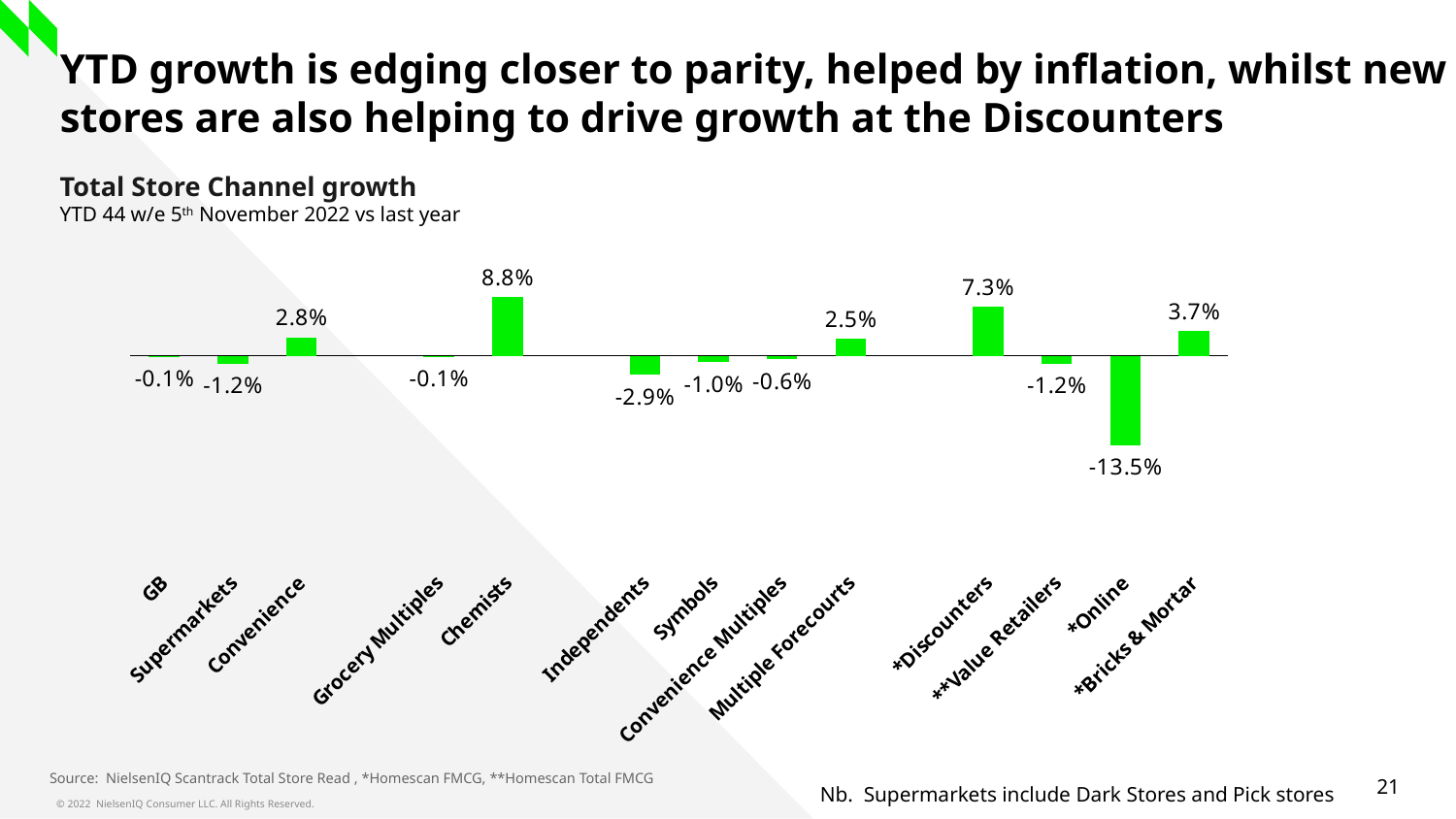
Which channel has the lowest YTD growth? Online What is the YTD growth value for Chemists? 8.8% What is the YTD growth value for Discounters? 7.3% What is the YTD growth value for Independents? -2.9% Which channel has the highest YTD growth? Chemists Which has higher YTD growth, Convenience or Multiple Forecourts? Convenience How many channels are shown on the chart? 13 What kind of chart is used to show Total Store Channel growth? Bar chart What is the YTD growth value for Bricks & Mortar? 3.7% What is the difference between the growth for Chemists and the growth for Discounters? 1.5 percentage points What is the YTD growth value for Online? -13.5% What is the title of the chart? Total Store Channel growth